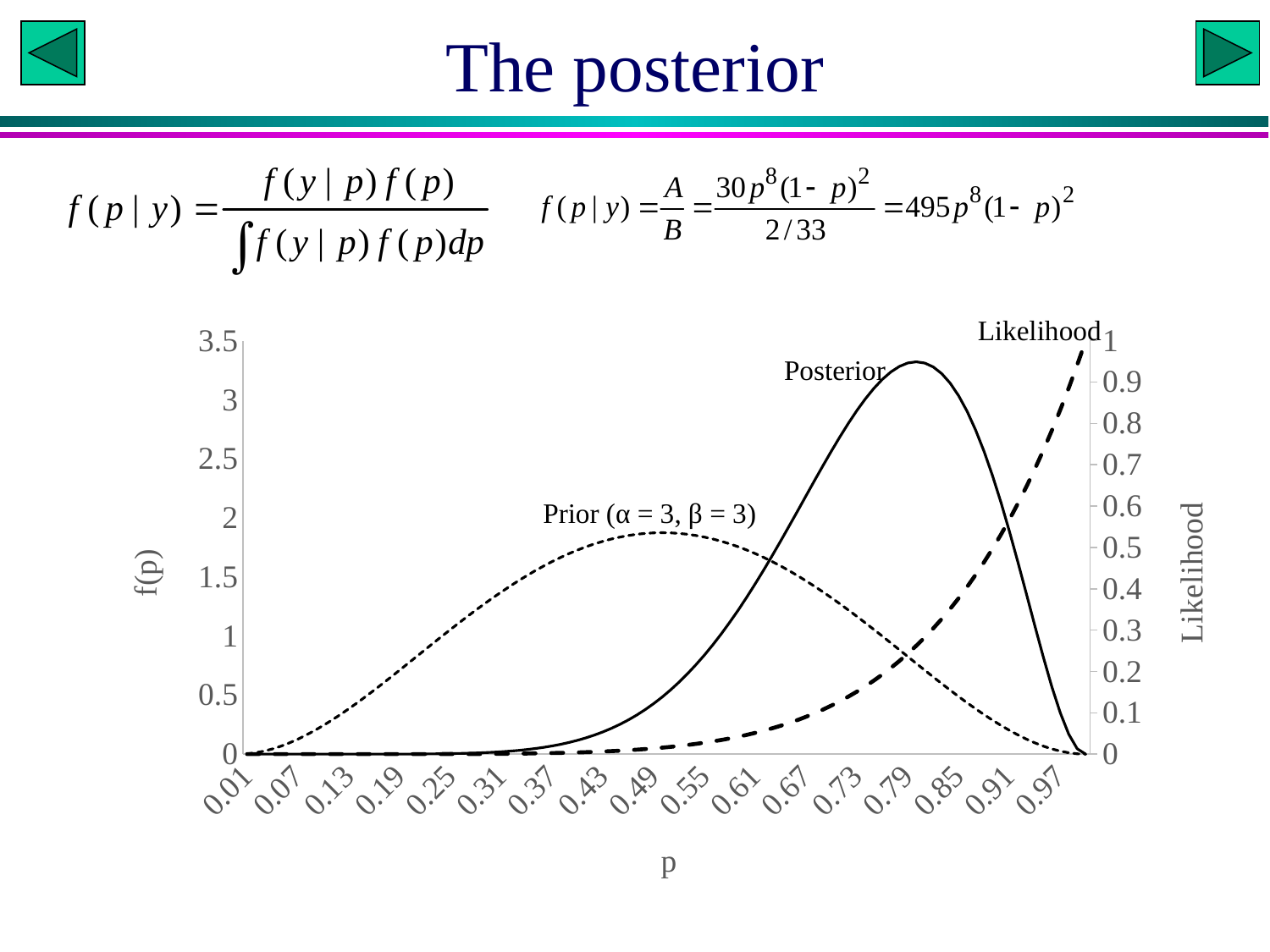
Is the Likelihood value at p = 0.79 greater or less than 0.5 on the right axis? less Is the peak value of the Prior curve greater or less than 2 on the left axis? less Is the Posterior value at p = 0.49 greater or less than 0.5 on the left axis? less How many tick labels are shown on the p axis? 17 What are the parameters of the Prior shown in its label on the chart? α = 3, β = 3 Does the Likelihood curve rise or fall as p increases along the x axis? rise How many curves are plotted on the chart? 3 What kind of chart is shown on the slide? line chart At p = 0.49, which curve is higher on the left axis, the Prior or the Posterior? Prior Which curve reaches the highest peak on the left f(p) axis? Posterior At p = 0.85, which curve is higher on the left axis, the Prior or the Posterior? Posterior